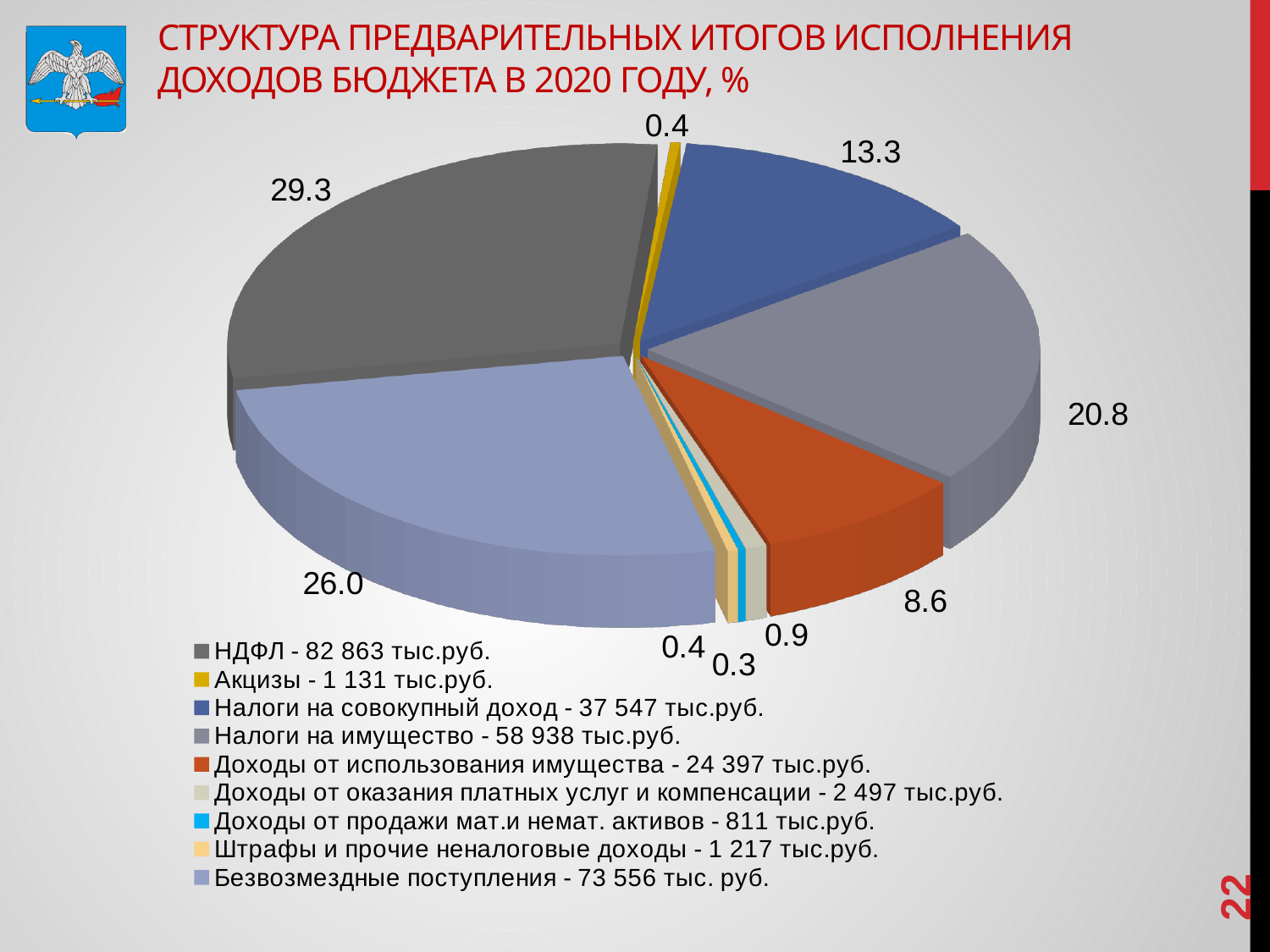
According to the legend, what is the amount for Акцизы in thousand rubles? 1 131 тыс.руб. Which slice is larger: Налоги на имущество or Налоги на совокупный доход? Налоги на имущество How many slices does the pie chart have? 9 What percentage share does Безвозмездные поступления have in the pie chart? 26.0 What percentage share does НДФЛ have in the pie chart? 29.3 What percentage share does Доходы от использования имущества have in the pie chart? 8.6 What is the difference in percentage points between the НДФЛ slice and the Безвозмездные поступления slice? 3.3 What percentage share does Налоги на имущество have in the pie chart? 20.8 Which category has the smallest slice in the pie chart? Доходы от продажи мат.и немат. активов Which category has the largest slice in the pie chart? НДФЛ What percentage share does Налоги на совокупный доход have in the pie chart? 13.3 What kind of chart is shown on the slide? pie chart